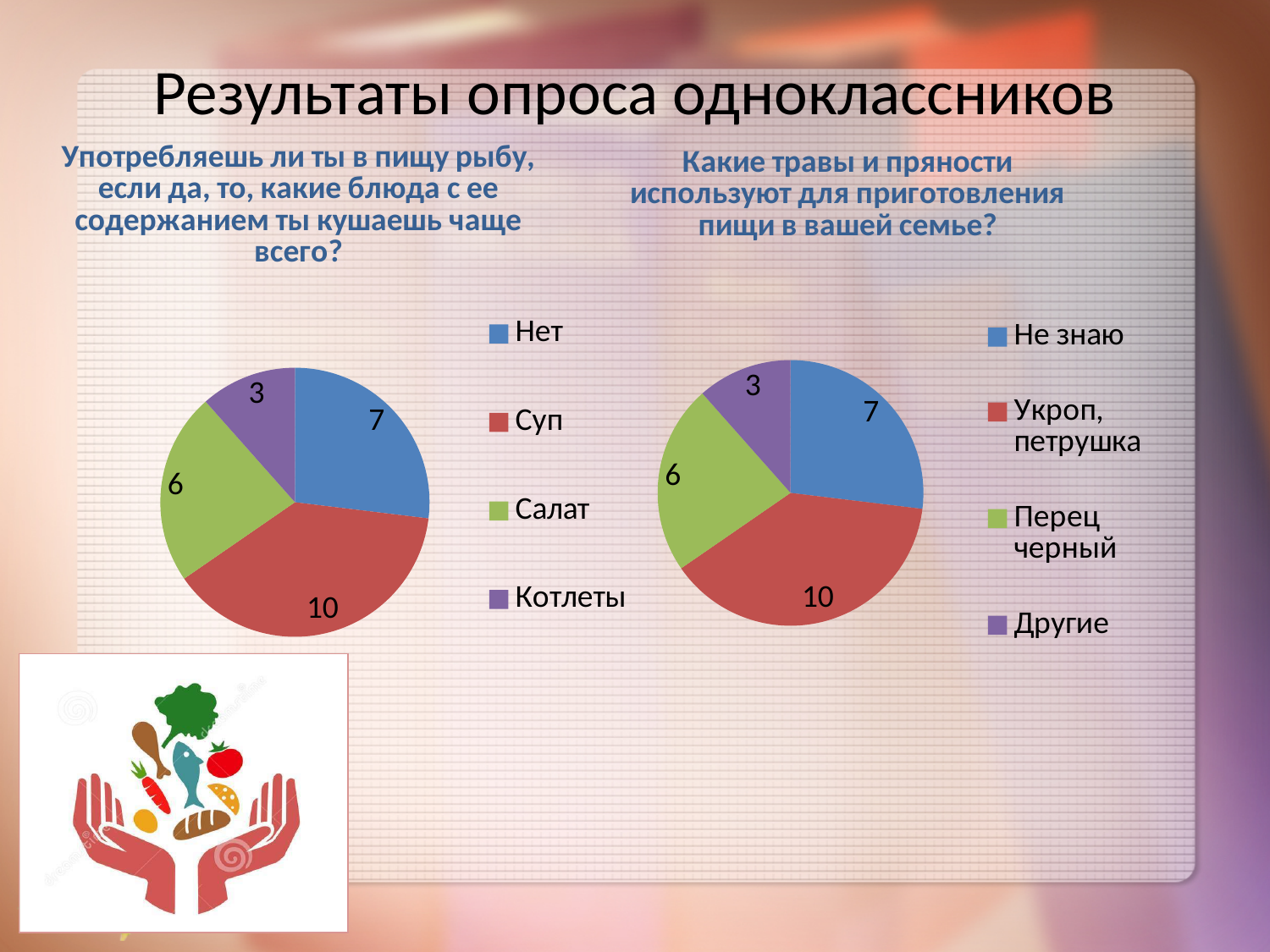
What type of chart is used on the right side of the slide? Pie chart In the left pie chart, what is the value for "Котлеты"? 3 In the left pie chart, how many respondents answered "Суп"? 10 How many categories does the left pie chart show? 4 In the right pie chart, which category has the smallest slice? Другие In the right pie chart, what is the value for "Перец черный"? 6 In the left pie chart, what is the difference between the values for "Суп" and "Салат"? 4 What is the total of all values in the right pie chart? 26 In the right pie chart, how many respondents answered "Не знаю"? 7 In the left pie chart, which category has the largest slice? Суп In the right pie chart, what colour is the "Укроп, петрушка" slice? Red In the right pie chart, which is larger: "Не знаю" or "Перец черный"? Не знаю